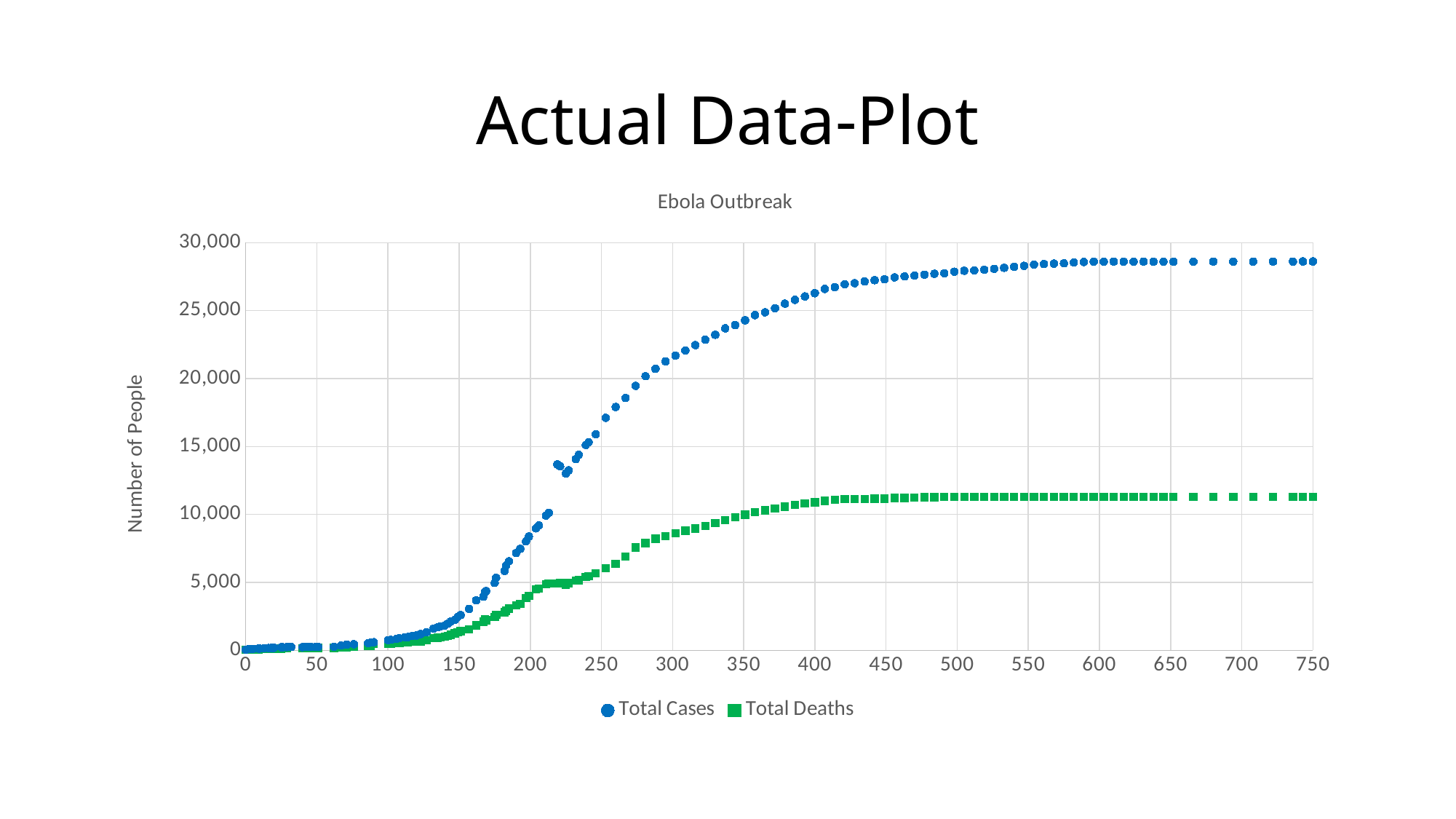
Is the value for Total Cases at x = 300 greater or less than 20,000? greater Do the Total Cases values rise or fall as the x axis increases? rise Which series is plotted with green square markers? Total Deaths What is the label of the y axis? Number of People Is the value for Total Cases at x = 750 greater or less than 25,000? greater How many series does the legend list? 2 Is the value for Total Cases at x = 100 greater or less than 5,000? less What kind of chart is shown on the slide? scatter chart What is the title of the chart? Ebola Outbreak Which series reaches higher values, Total Cases or Total Deaths? Total Cases